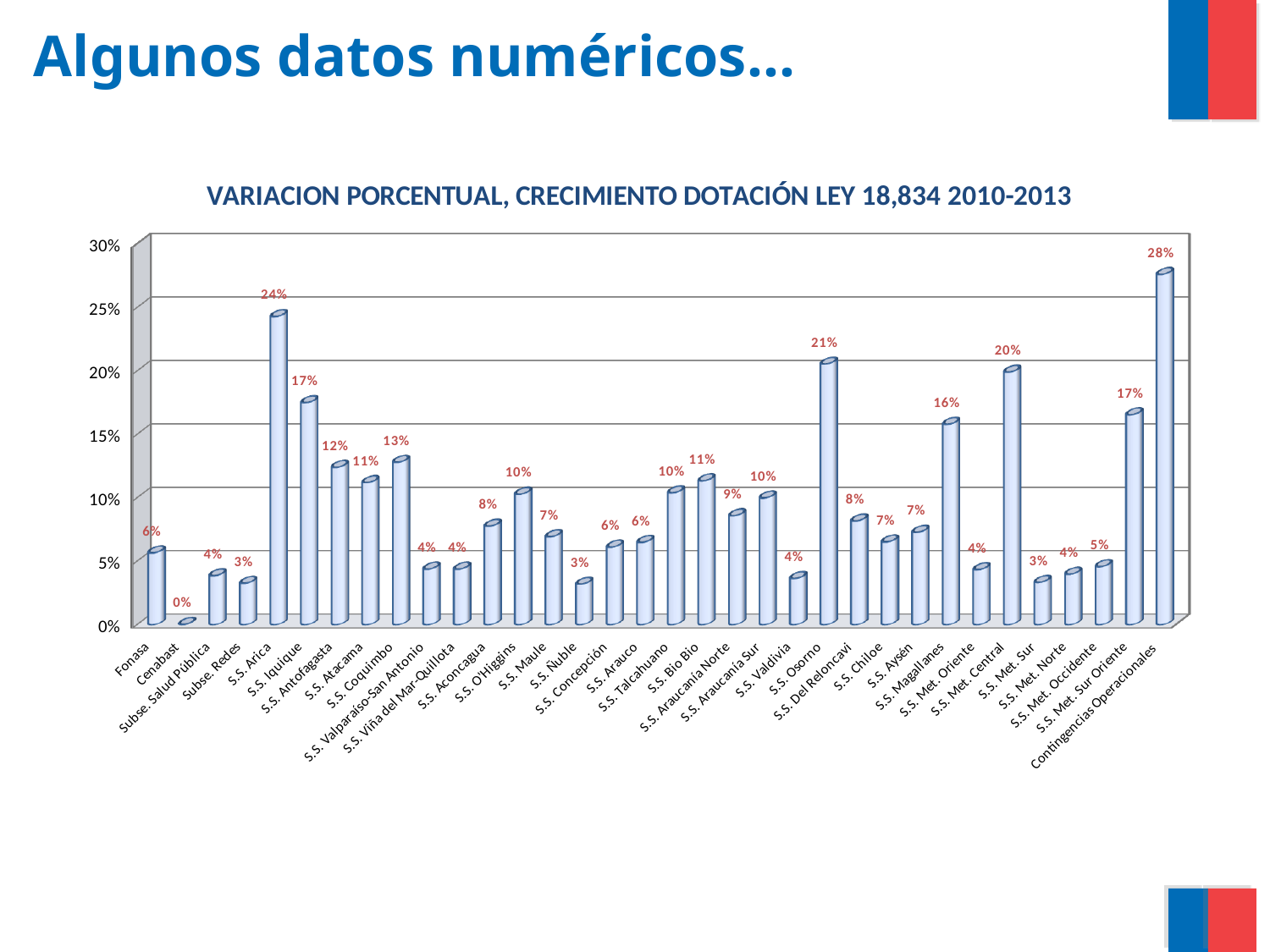
Which category has the lowest value? Cenabast What is the value for S.S. Arica? 24% Which is larger, the value for S.S. Met. Central or the value for S.S. Met. Sur Oriente? S.S. Met. Central What is the value for S.S. Osorno? 21% How many categories are shown on the x axis? 34 What is the value for S.S. Magallanes? 16% Is the value for S.S. Coquimbo greater or less than 10%? greater What kind of chart is shown on the slide? bar chart What is the title of the chart? VARIACION PORCENTUAL, CRECIMIENTO DOTACIÓN LEY 18,834 2010-2013 What is the value for Cenabast? 0% What is the difference between the values for S.S. Arica and S.S. Iquique? 7% Which category has the highest value? Contingencias Operacionales